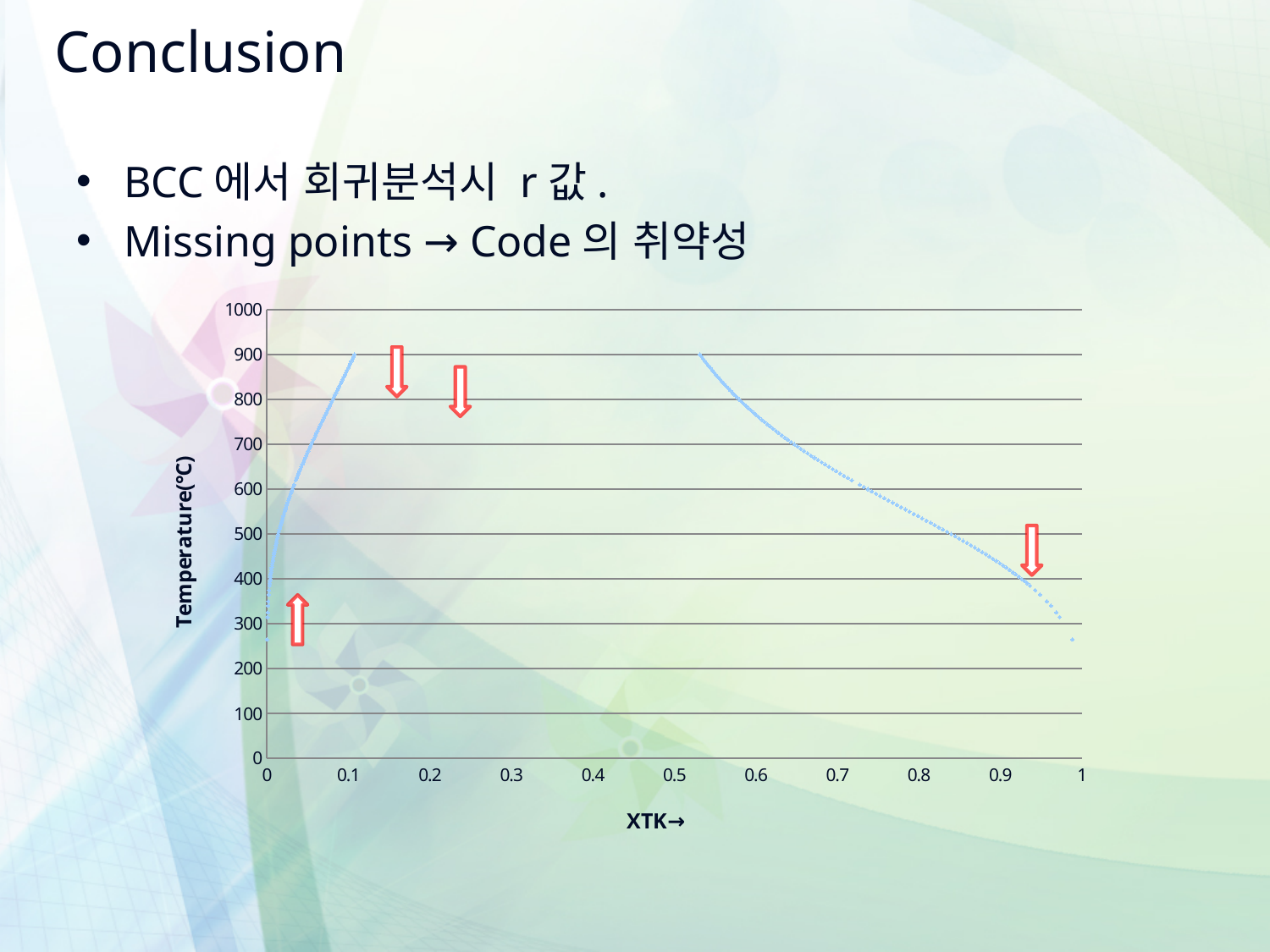
Is the temperature of the right-hand curve at XTK = 0.55 greater or less than 700? greater What is the label of the vertical axis of the chart? Temperature(°C) Is the temperature of the right-hand curve at XTK = 0.9 greater or less than 500? less Is the temperature of the right-hand curve at XTK = 0.8 greater or less than 500? greater What kind of chart is shown on the slide? scatter chart What is the highest value shown on the vertical axis of the chart? 1000 What is the label of the horizontal axis of the chart? XTK→ How many separate curves of data points are plotted on the chart? 2 Does the left-hand curve rise or fall as XTK increases? rises Does the right-hand curve rise or fall as XTK increases? falls